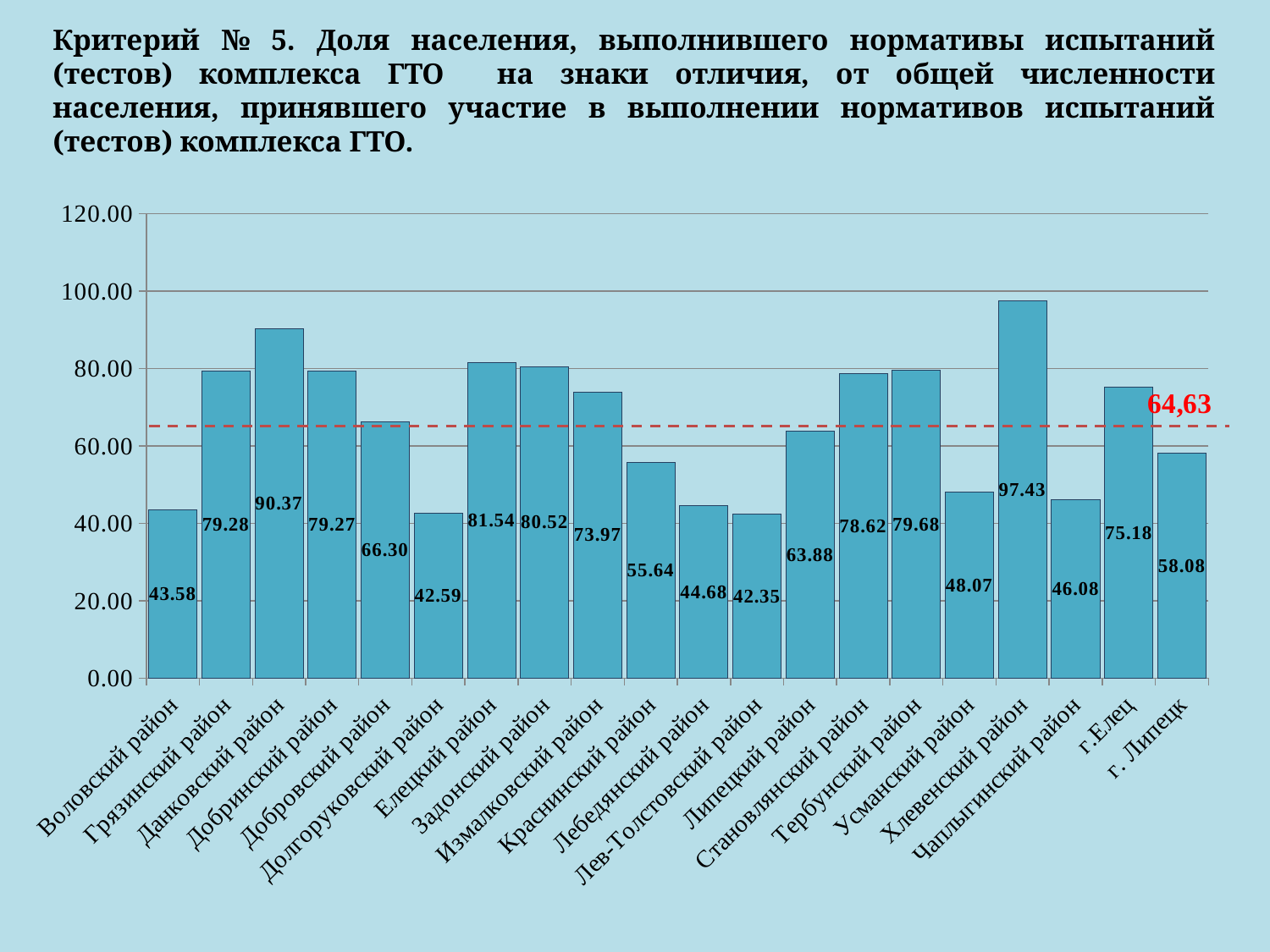
What is the difference between the values for Елецкий район and г.Елец? 6.36 What is the value for Данковский район? 90.37 Which is larger, the value for Краснинский район or the value for Липецкий район? Липецкий район What is the difference between the values for Хлевенский район and Воловский район? 53.85 What value is marked by the red dashed horizontal line on the chart? 64,63 What is the value for г. Липецк? 58.08 How many districts (categories) are shown on the chart? 20 Which district has the lowest value? Лев-Толстовский район Which district has the highest value? Хлевенский район What kind of chart is shown on the slide? bar chart What is the value for Усманский район? 48.07 Is the value for Задонский район greater or less than 80.00? greater